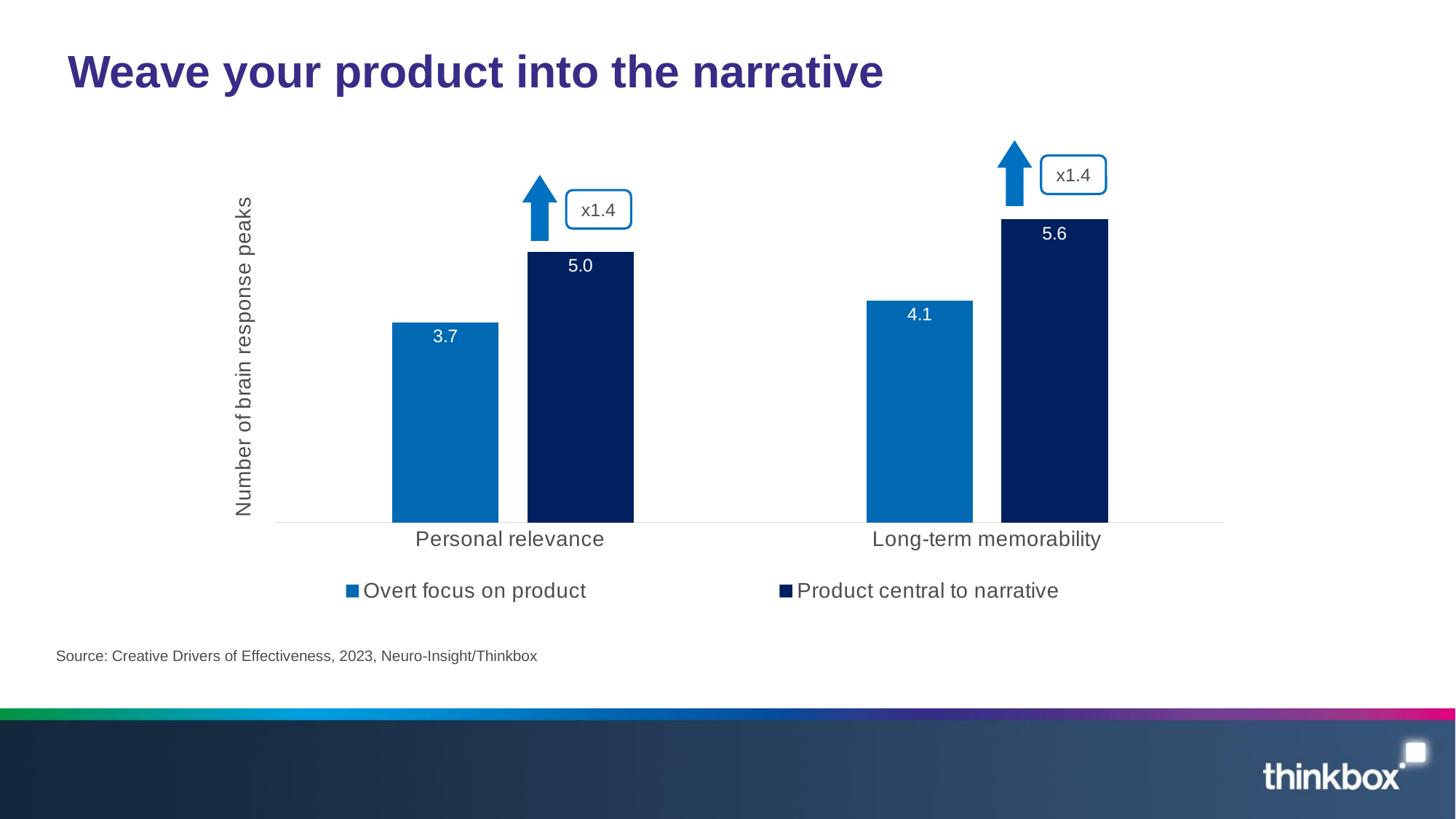
What is the value for Product central to narrative under Personal relevance? 5.0 Which bar has the lowest value on the chart? Overt focus on product, Personal relevance What is the value for Overt focus on product under Personal relevance? 3.7 What is the value for Overt focus on product under Long-term memorability? 4.1 For Long-term memorability, which is larger: Overt focus on product or Product central to narrative? Product central to narrative What is the value for Product central to narrative under Long-term memorability? 5.6 How many series does the legend list? 2 What kind of chart is shown on the slide? Bar chart How many categories are shown on the x axis? 2 What is the difference between Product central to narrative and Overt focus on product for Personal relevance? 1.3 What is the difference between Product central to narrative and Overt focus on product for Long-term memorability? 1.5 Which bar has the highest value on the chart? Product central to narrative, Long-term memorability